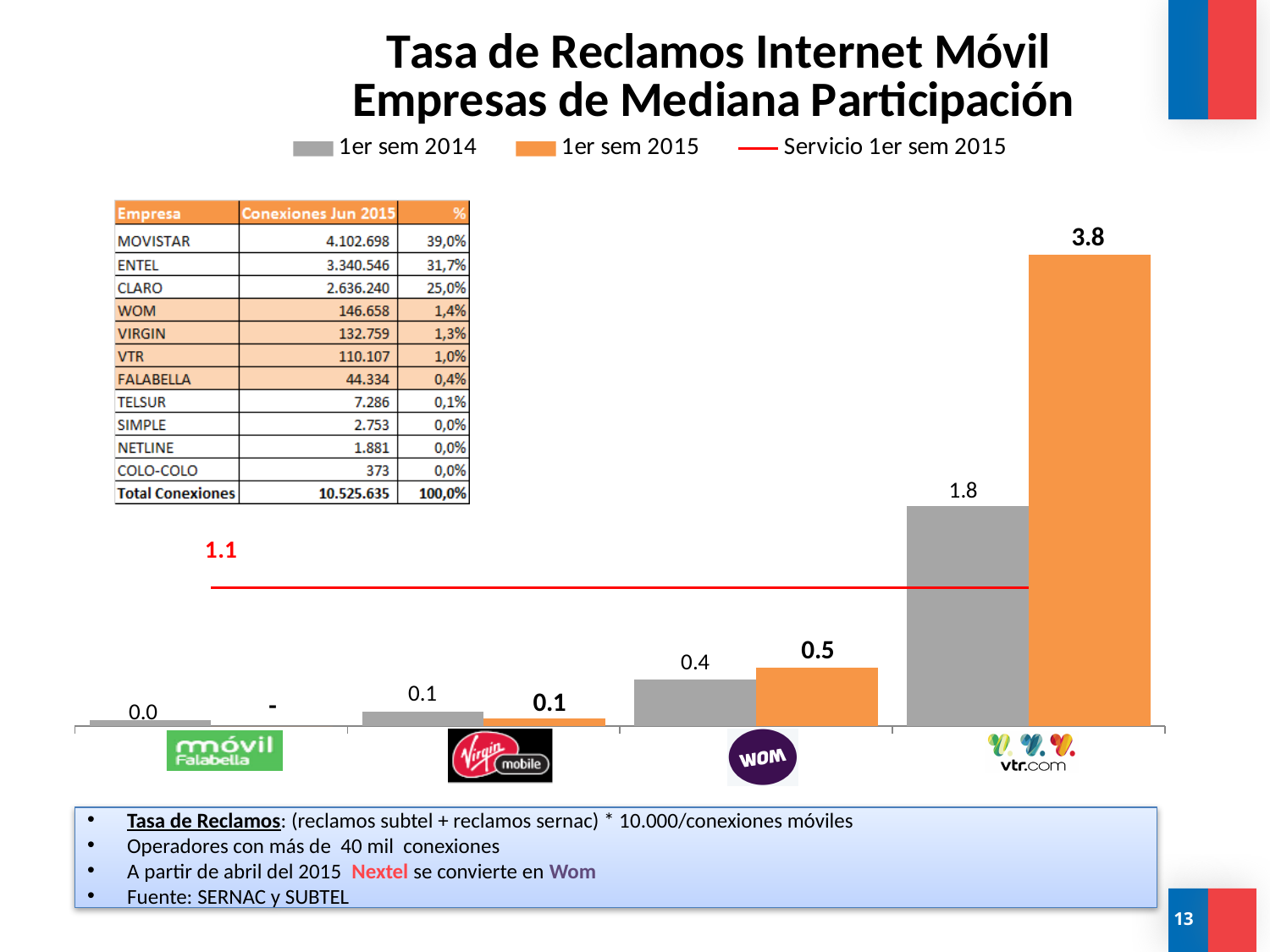
What is the difference between the 1er sem 2015 and 1er sem 2014 values for VTR? 2.0 Which company has the highest 1er sem 2015 value? VTR What is the 1er sem 2014 value for VTR? 1.8 How many series does the legend list? 3 What value does the Servicio 1er sem 2015 line show? 1.1 What is the 1er sem 2015 value for WOM? 0.5 What is the 1er sem 2014 value for WOM? 0.4 What is the 1er sem 2014 value for Móvil Falabella? 0.0 What is the 1er sem 2015 value for VTR? 3.8 Which is larger for WOM, the 1er sem 2014 value or the 1er sem 2015 value? 1er sem 2015 How many companies are shown on the x axis of the chart? 4 What kind of chart is shown on the slide? Combination bar and line chart